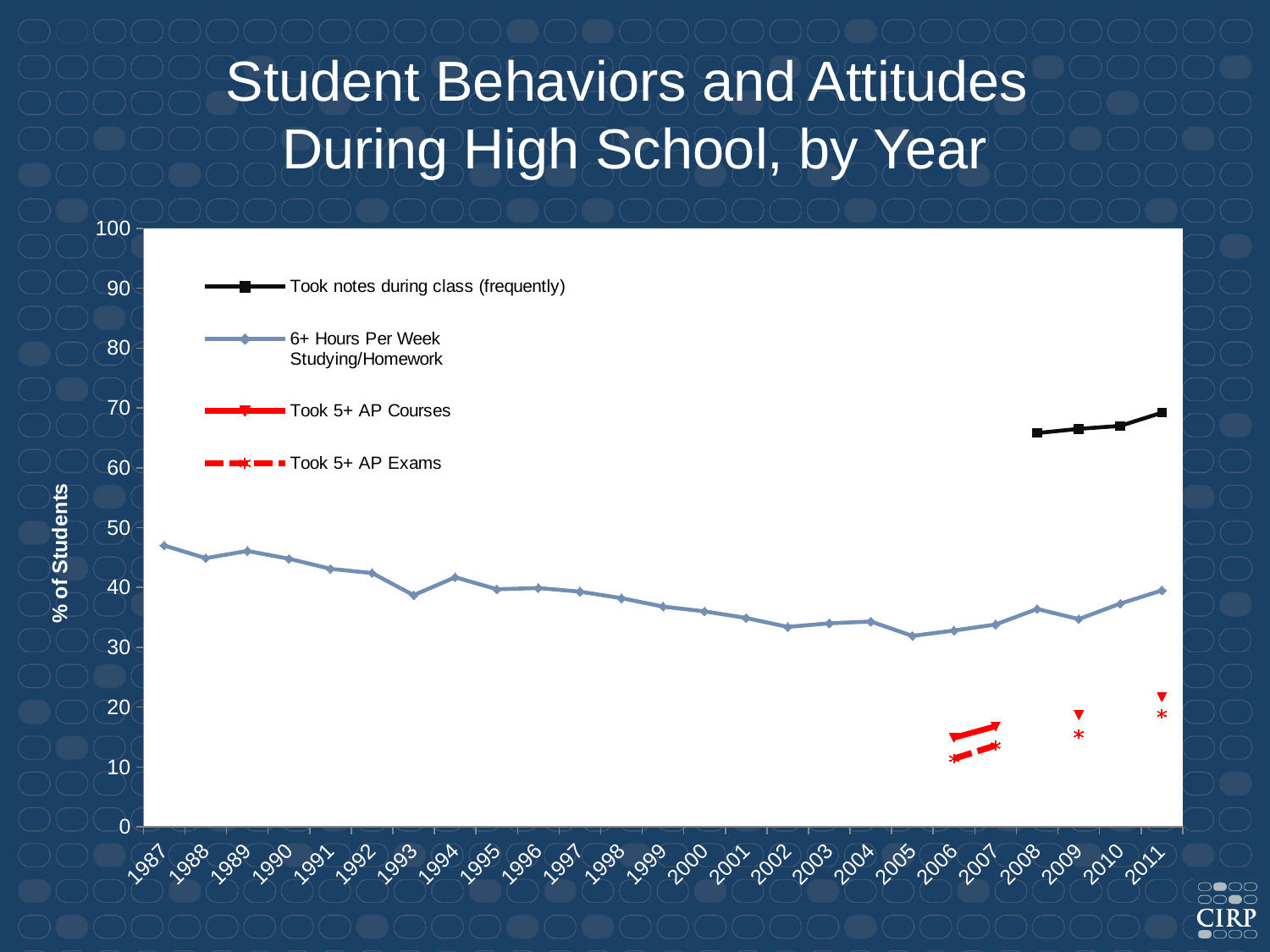
Is the value for 'Took notes during class (frequently)' in 2011 greater or less than 60? greater Is the value for '6+ Hours Per Week Studying/Homework' in 2005 greater or less than 40? less How many years are shown along the x axis? 25 How many series does the legend list? 4 Does the 'Took notes during class (frequently)' series rise or fall from 2008 to 2011? rise What is the title of the chart? Student Behaviors and Attitudes During High School, by Year Is the value for 'Took 5+ AP Exams' in 2006 greater or less than 20? less What kind of chart is shown on the slide? line chart In 2011, which series has the higher value: 'Took notes during class (frequently)' or '6+ Hours Per Week Studying/Homework'? Took notes during class (frequently) What is the label on the y axis? % of Students